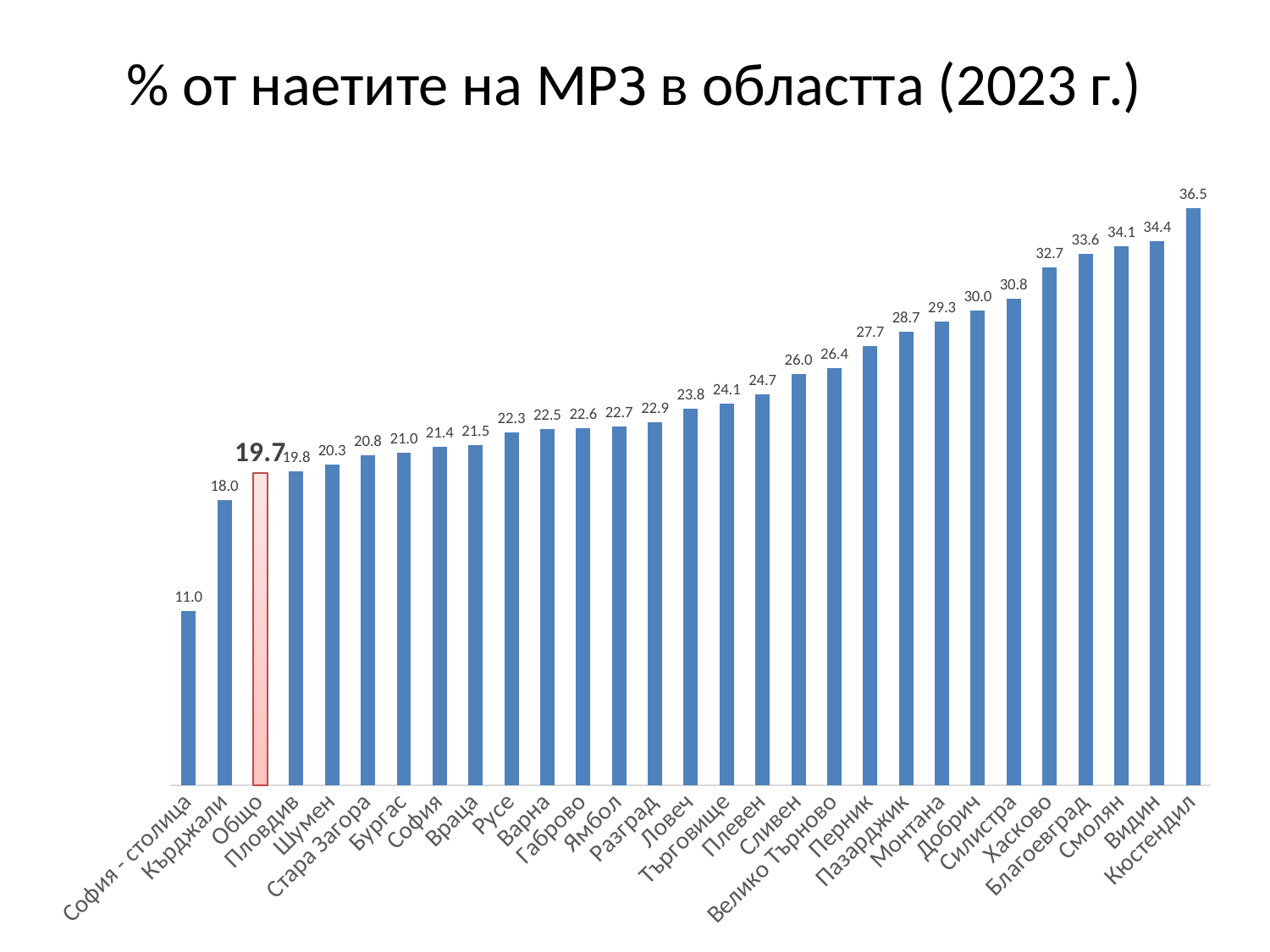
What is the difference between the values for Видин and Смолян? 0.3 What is the difference between the values for Кюстендил and София - столица? 25.5 Which category has the lowest value? София - столица How many bars are shown in the chart? 29 What kind of chart is shown on the slide? Bar chart What is the value for the bar labelled Общо? 19.7 What is the value for Кюстендил? 36.5 Which category has the highest value? Кюстендил Do the values rise or fall from left to right along the x axis? Rise Which is larger, the value for Перник or the value for Сливен? Перник What is the value for Велико Търново? 26.4 What is the value for София - столица? 11.0